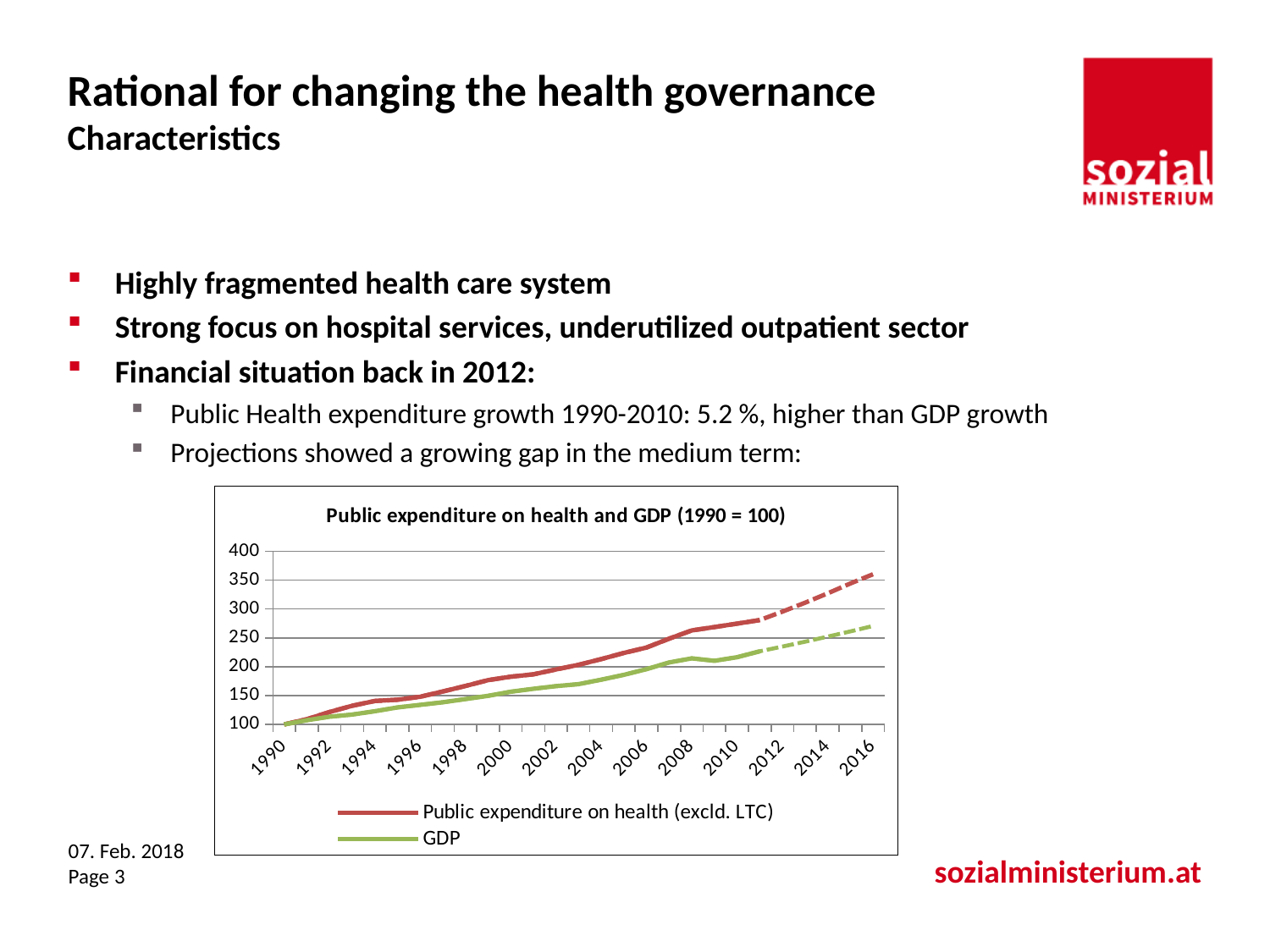
What is the title of the chart? Public expenditure on health and GDP (1990 = 100) How many year labels are shown on the x axis of the chart? 14 What is the value of the GDP series in 1990? 100 What kind of chart is shown on the slide? Line chart Is the value for Public expenditure on health (excld. LTC) in 2016 greater or less than 300? greater Which series is higher in 2016, Public expenditure on health (excld. LTC) or GDP? Public expenditure on health (excld. LTC) Is the value for GDP in 2010 greater or less than 250? less Which two series are listed in the chart's legend? Public expenditure on health (excld. LTC) and GDP How many series does the chart's legend list? 2 Do the values of the Public expenditure on health (excld. LTC) series rise or fall from 1990 to 2016? Rise Is the value for Public expenditure on health (excld. LTC) in 2010 greater or less than 250? greater